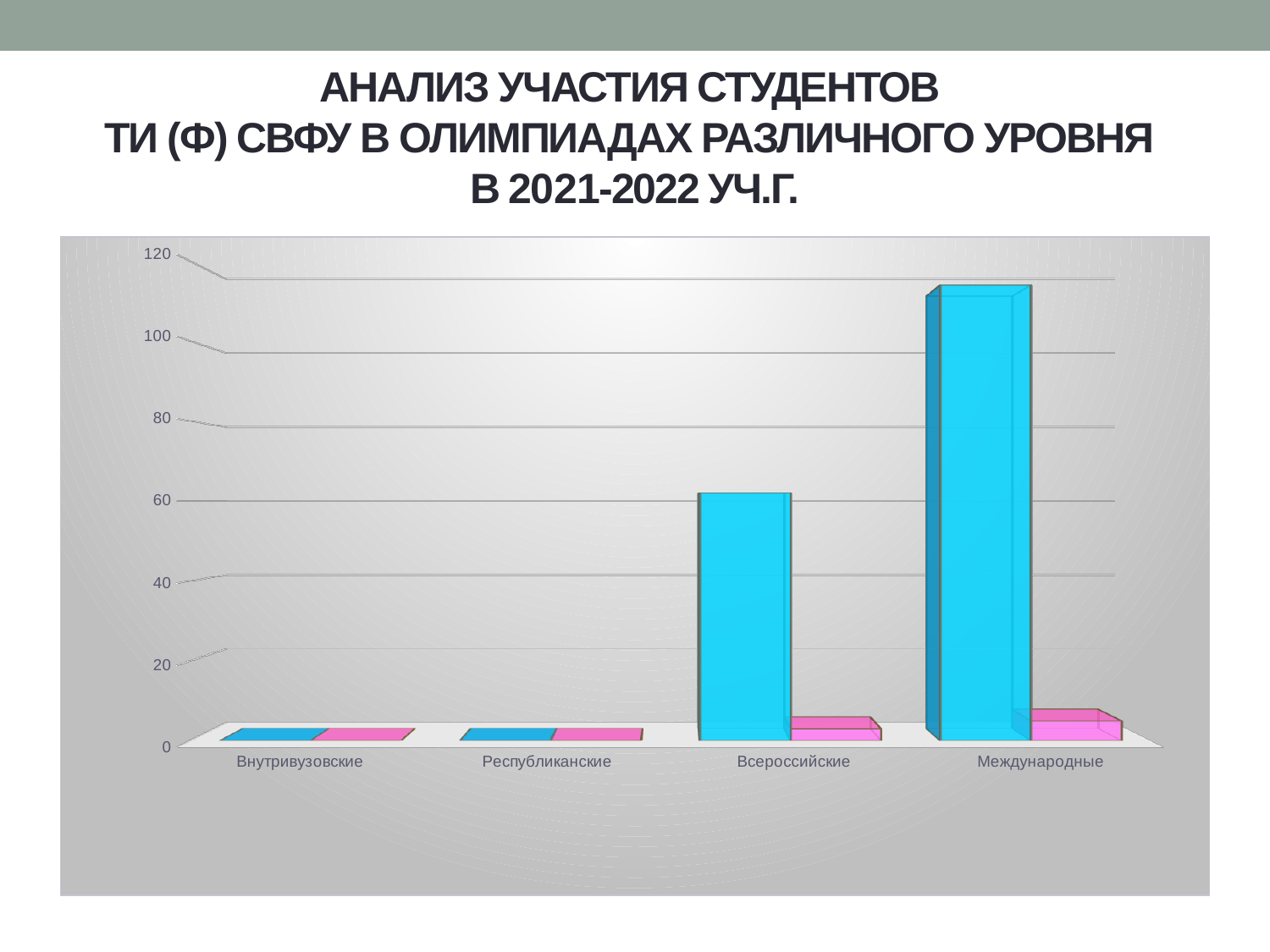
Is the blue bar for Всероссийские greater or less than 80? less How many bars are shown for each category? 2 Which category has the tallest blue bar? Международные What kind of chart is shown on the slide? bar chart How many categories are shown on the x axis? 4 Is the blue bar for Международные greater or less than 100? greater Is the blue bar for Всероссийские greater or less than 40? greater Which is larger, the blue bar for Всероссийские or the blue bar for Международные? Международные Do the blue bars rise or fall from left to right along the x axis? rise In the Всероссийские category, which bar is taller, the blue one or the pink one? the blue one